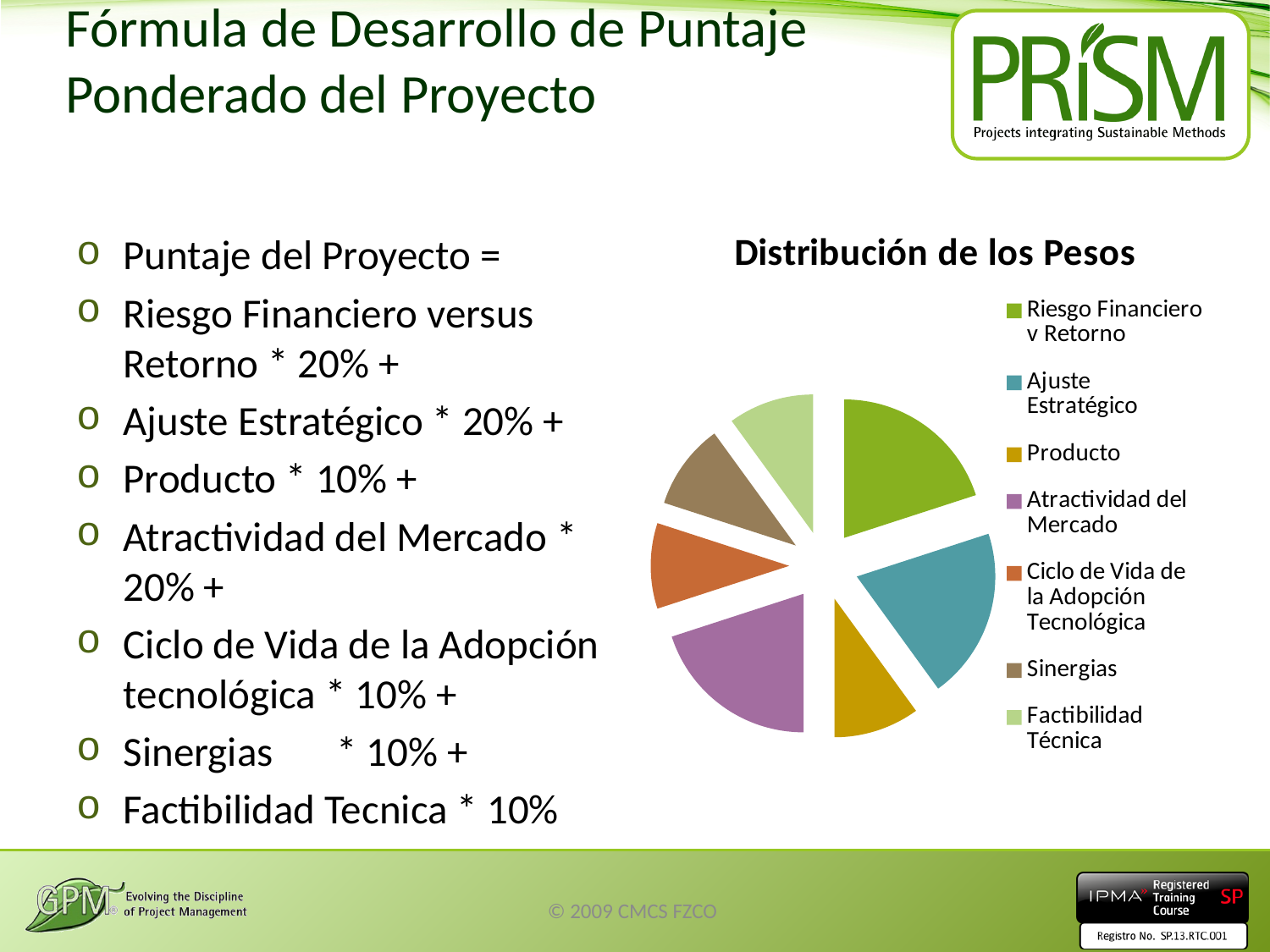
Which slice is larger in the pie chart: Atractividad del Mercado or Factibilidad Técnica? Atractividad del Mercado Which slice is larger in the pie chart: Riesgo Financiero y Retorno or Producto? Riesgo Financiero v Retorno Which slice is larger in the pie chart: Ajuste Estratégico or Sinergias? Ajuste Estratégico What is the title of the chart on the slide? Distribución de los Pesos How many slices does the pie chart have? 7 Which legend entry is listed first in the pie chart's legend? Riesgo Financiero v Retorno How many entries does the chart's legend list? 7 What kind of chart is shown on the slide? pie chart